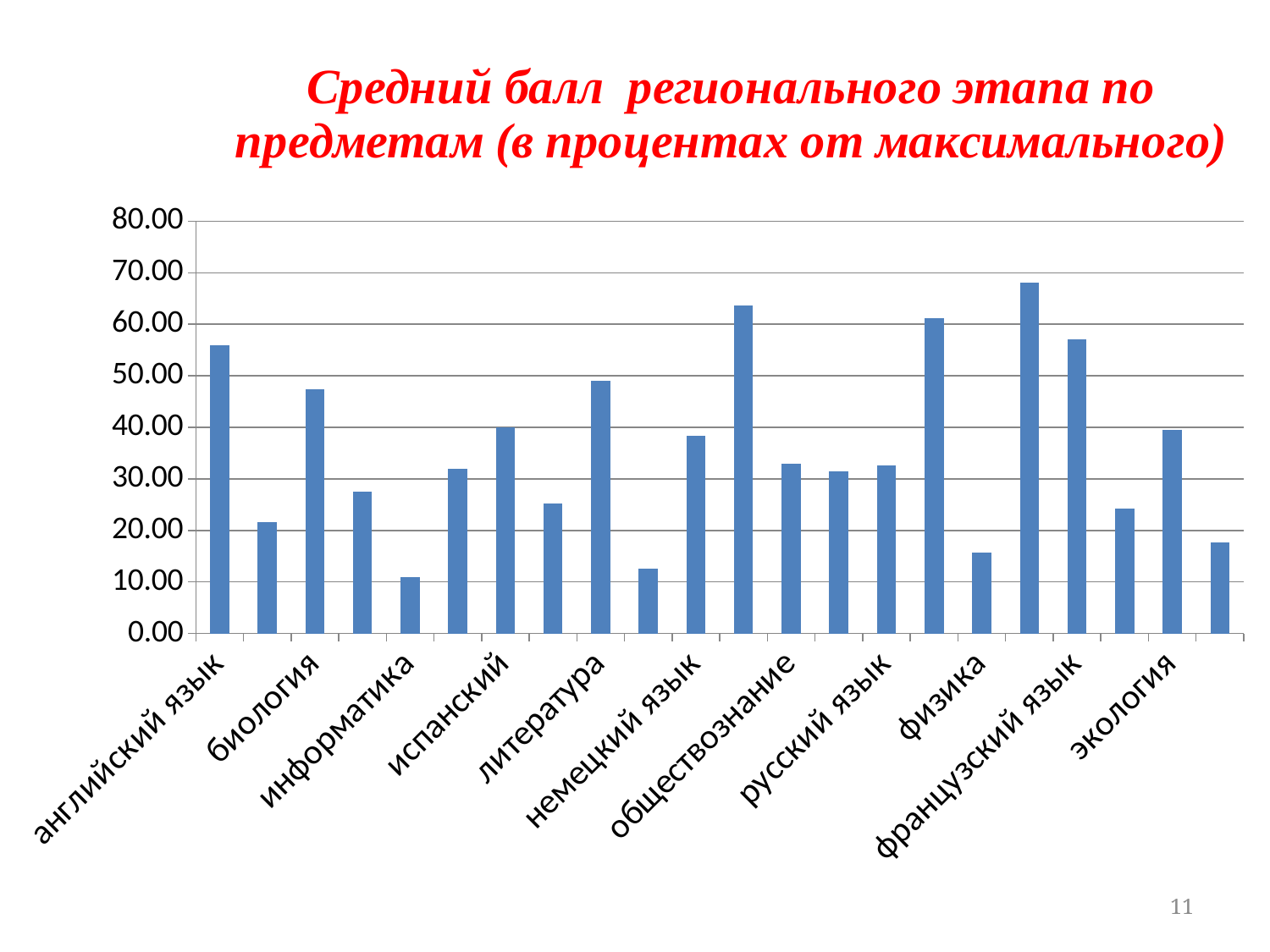
Is the value for биология greater or less than 40? greater Which is larger, the value for физика or the value for экология? экология How many bars are plotted in the chart? 22 Is the value for французский язык greater or less than 50? greater Is the value for физика greater or less than 20? less What kind of chart is shown on the slide? bar chart What is the title of the chart? Средний балл регионального этапа по предметам (в процентах от максимального) Which is larger, the value for английский язык or the value for биология? английский язык